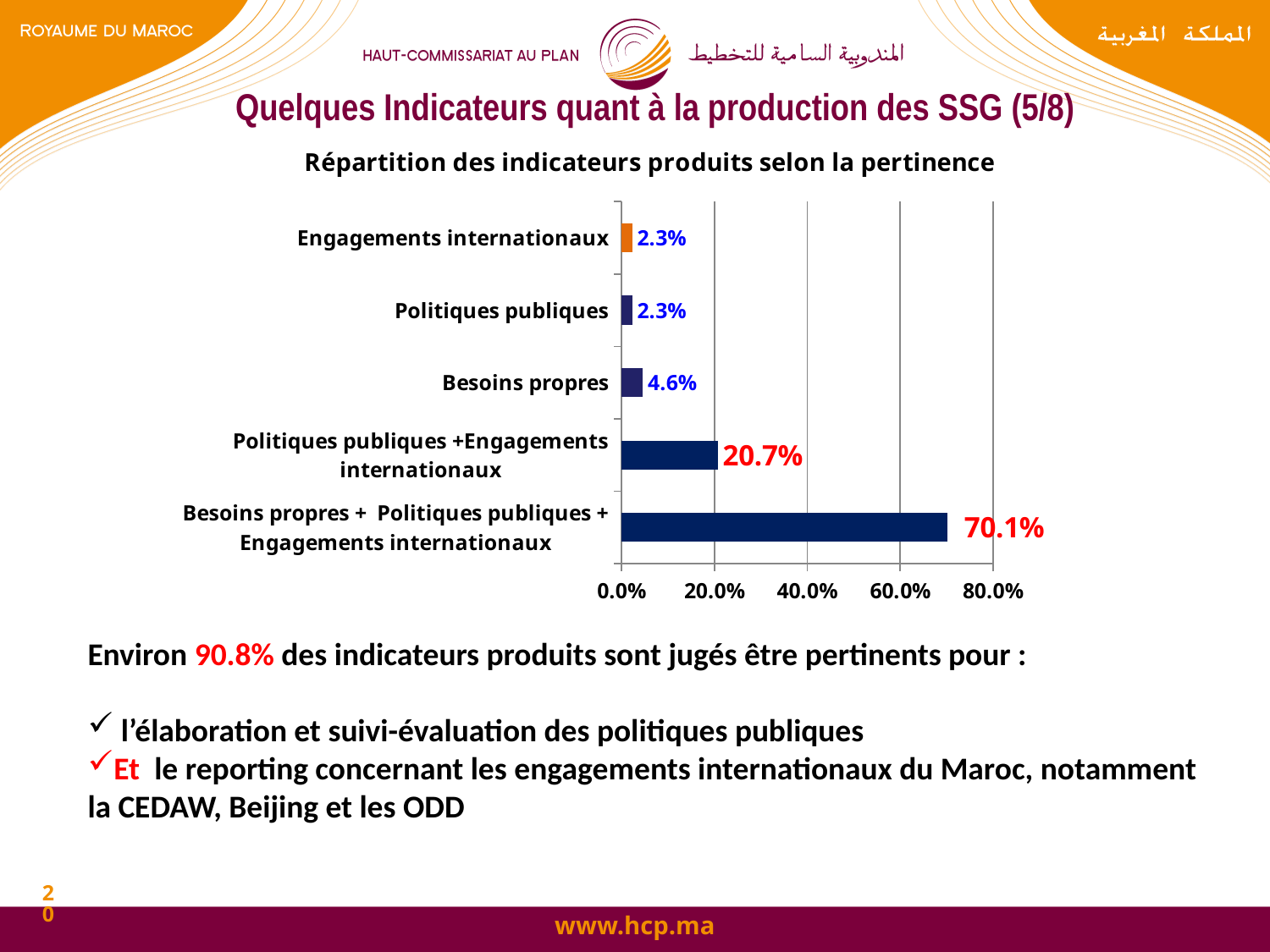
Is the value for "Politiques publiques +Engagements internationaux" greater or less than 40.0%? less What is the difference between the values for "Besoins propres" and "Politiques publiques"? 2.3% Which is larger, the value for "Besoins propres" or the value for "Politiques publiques"? Besoins propres What is the title of the chart? Répartition des indicateurs produits selon la pertinence What is the value for "Besoins propres"? 4.6% How many categories are shown in the chart? 5 What is the difference between the values for "Besoins propres + Politiques publiques + Engagements internationaux" and "Politiques publiques +Engagements internationaux"? 49.4% Which category has the highest value? Besoins propres + Politiques publiques + Engagements internationaux What is the value for "Besoins propres + Politiques publiques + Engagements internationaux"? 70.1% What is the value for "Engagements internationaux"? 2.3% What is the value for "Politiques publiques +Engagements internationaux"? 20.7% What kind of chart is shown on the slide? bar chart